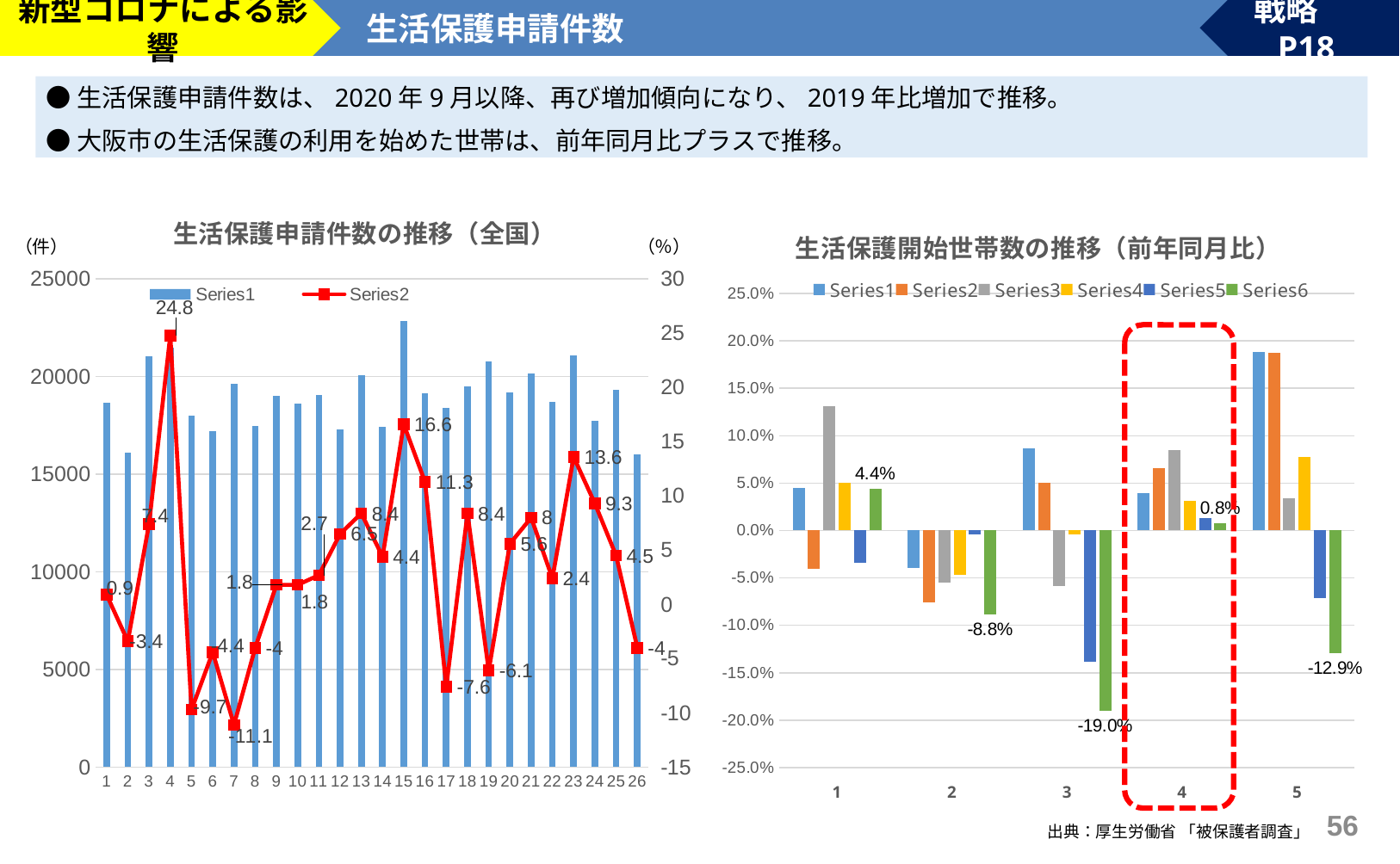
In the right chart (生活保護開始世帯数の推移（前年同月比）), what is the labelled Series6 value for category 3? -19.0% In the left chart (生活保護申請件数の推移（全国）), is the Series1 bar at point 15 greater or less than 20000? greater What kind of chart is the left chart, 生活保護申請件数の推移（全国）? A combination bar and line chart How many series does the legend of the right chart (生活保護開始世帯数の推移（前年同月比）) list? 6 How many categories are shown on the x axis of the right chart (生活保護開始世帯数の推移（前年同月比）)? 5 In the right chart (生活保護開始世帯数の推移（前年同月比）), which category has the lowest Series6 value? 3 In the left chart (生活保護申請件数の推移（全国）), which has the larger Series2 value, point 15 or point 16? Point 15 In the left chart (生活保護申請件数の推移（全国）), what is the difference between the Series2 values at point 4 and point 15? 8.2 How many x-axis points are shown in the left chart (生活保護申請件数の推移（全国）)? 26 In the left chart (生活保護申請件数の推移（全国）), at which x-axis point does Series2 reach its highest value? 4 In the left chart (生活保護申請件数の推移（全国）), what is the Series2 value at point 4? 24.8 In the left chart (生活保護申請件数の推移（全国）), at which x-axis point does Series2 reach its lowest value? 7